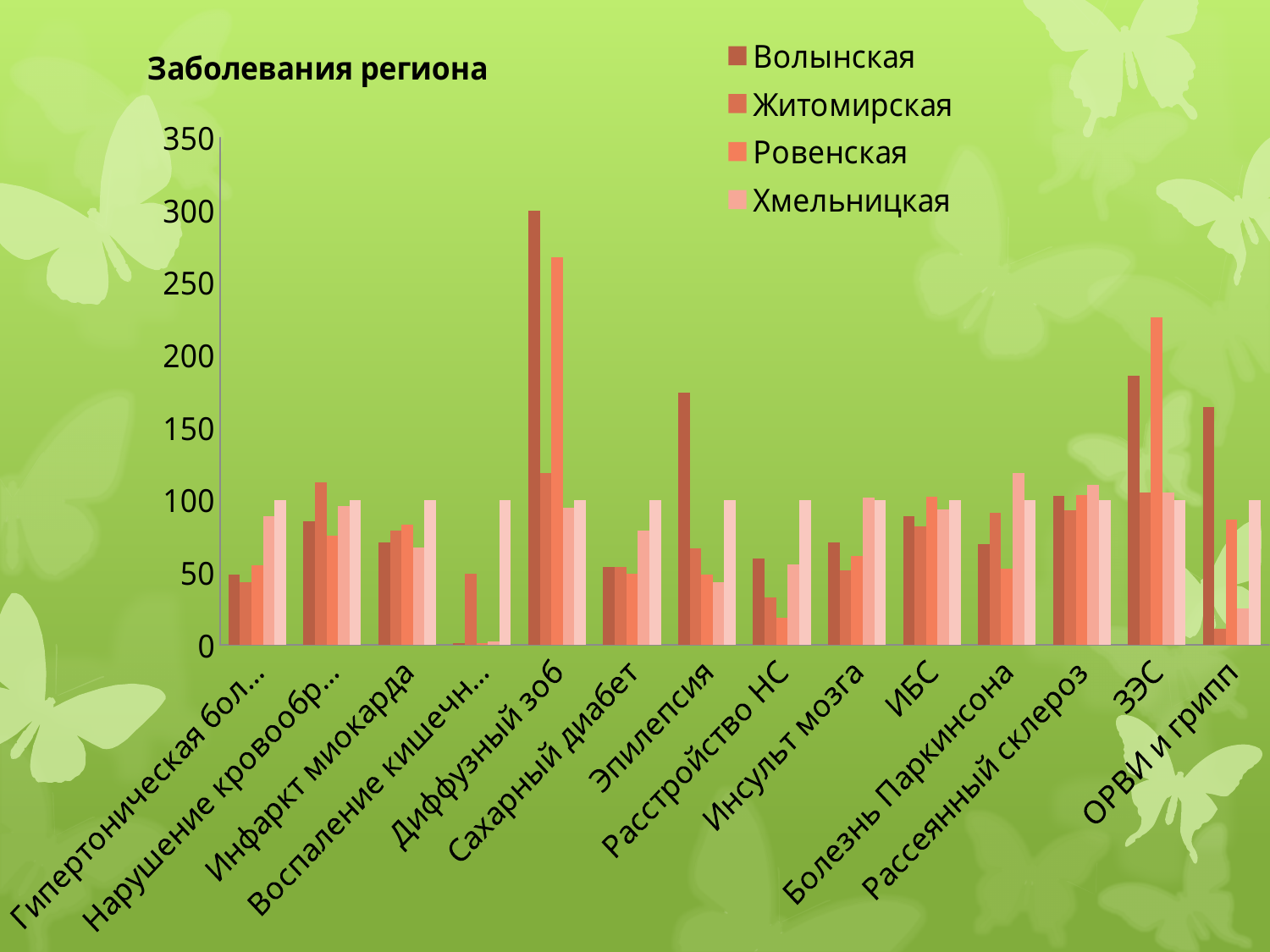
Which series is listed first in the legend? Волынская How many series does the legend list? 4 Is the Волынская value for Эпилепсия greater or less than 150? greater Is the Ровенская value for ЗЭС greater or less than 200? greater For Диффузный зоб, which is larger: the Волынская value or the Ровенская value? Волынская For which category is the Волынская bar the highest? Диффузный зоб Is the Житомирская value for Расстройство НС greater or less than 50? less What is the title of the chart? Заболевания региона For ЗЭС, which is larger: the Волынская value or the Житомирская value? Волынская What kind of chart is shown on the slide? bar chart How many disease categories are shown on the x axis? 14